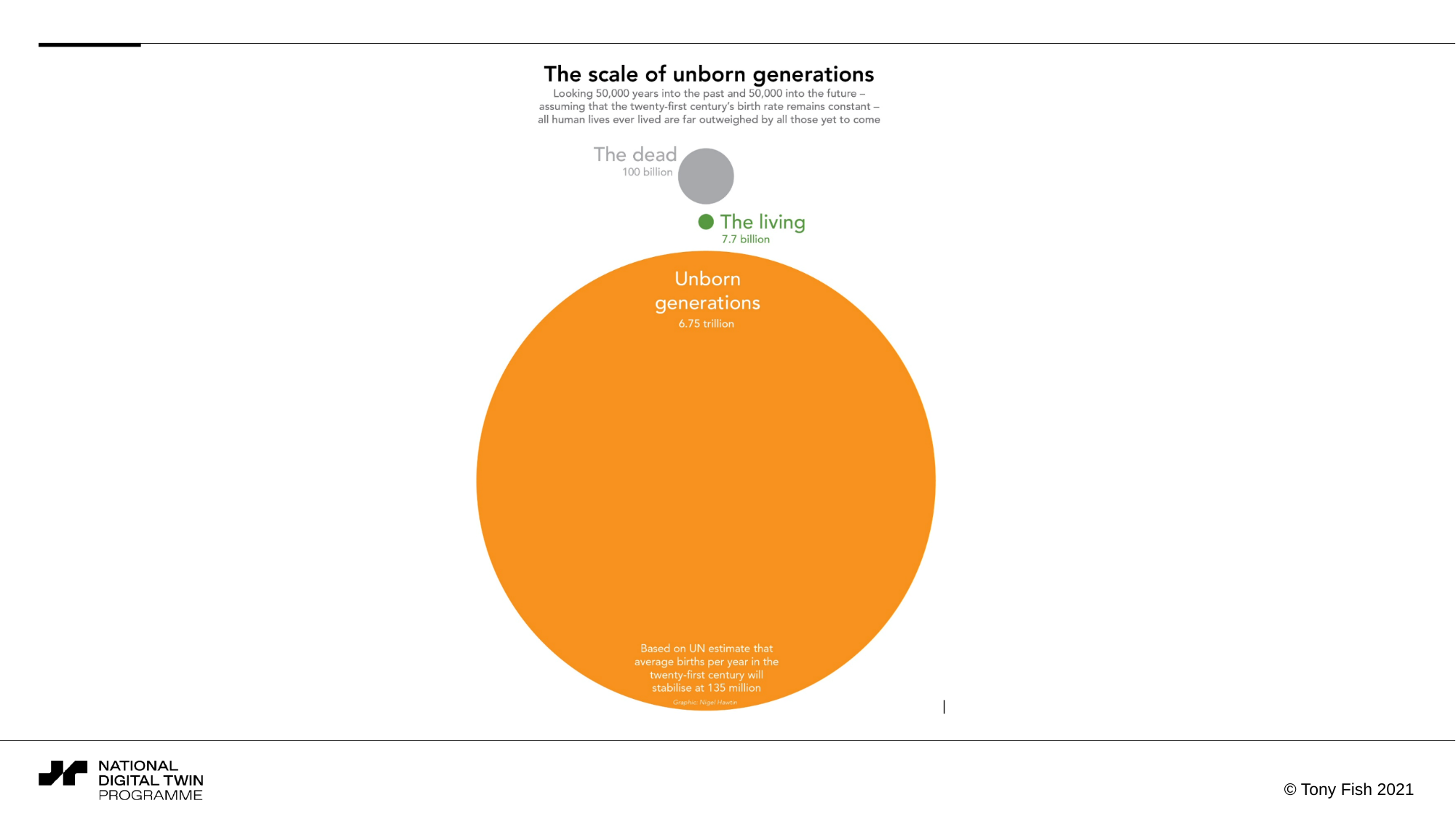
What colour is the circle representing Unborn generations? Orange What value is shown for The living? 7.7 billion Which category has the largest value? Unborn generations What value is shown for Unborn generations? 6.75 trillion What is the difference between the value for The dead and the value for The living? 92.3 billion Which category has the smallest value? The living How many categories are shown in the chart? 3 What kind of chart is this? Bubble chart What is the title of the chart? The scale of unborn generations What is the difference between the value for Unborn generations and the value for The dead? 6.65 trillion Which is larger, The dead or The living? The dead What value is shown for The dead? 100 billion